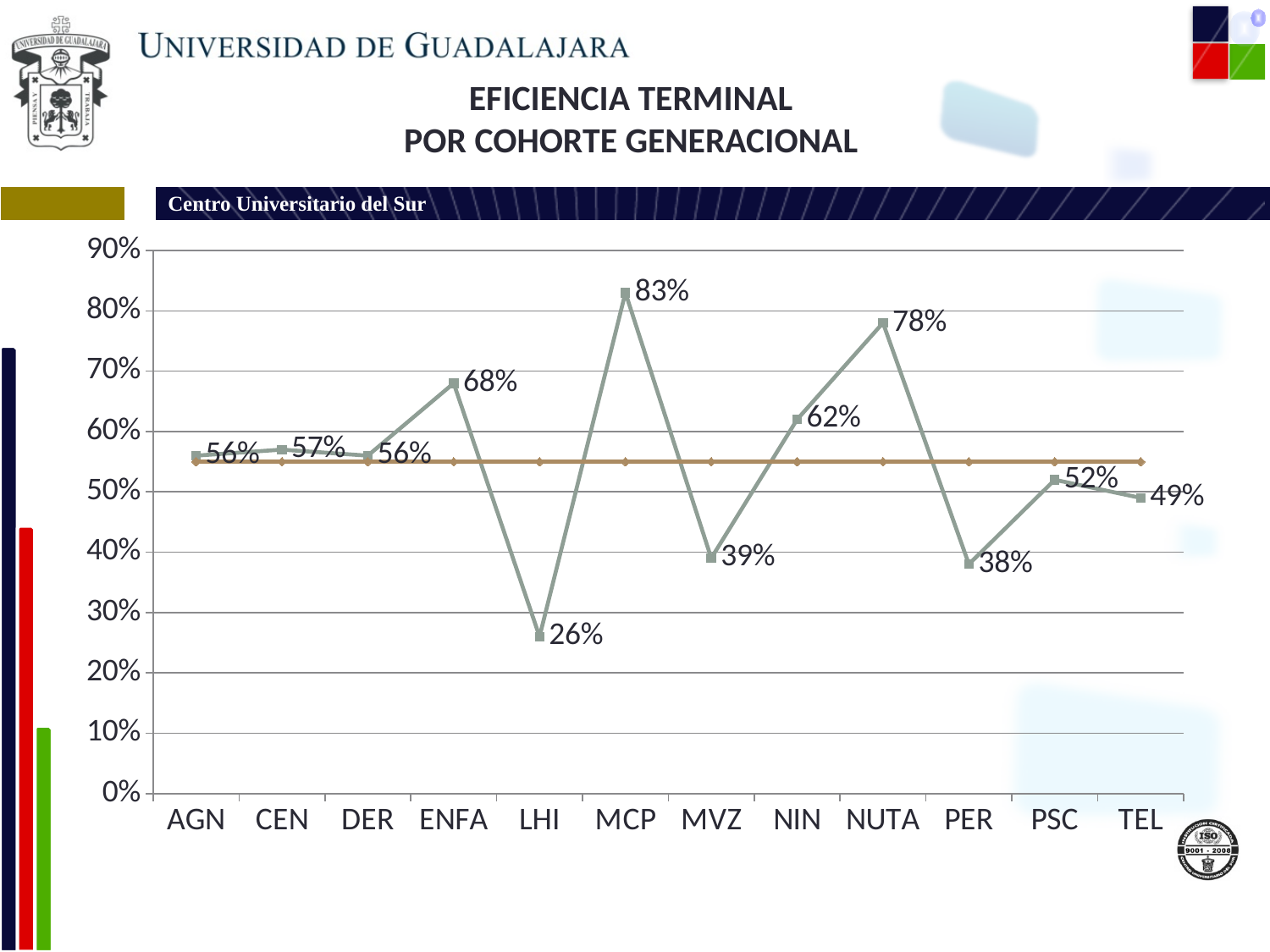
What kind of chart is shown on the slide? Line chart Which category has the lowest value? LHI What is the value for MCP? 83% Which is larger, the value for MVZ or the value for PSC? PSC What is the value for TEL? 49% What is the value for LHI? 26% What is the difference between the values for ENFA and NIN? 6% What is the difference between the values for MCP and LHI? 57% Which category has the highest value? MCP How many categories are shown on the x axis? 12 What is the value for NUTA? 78%